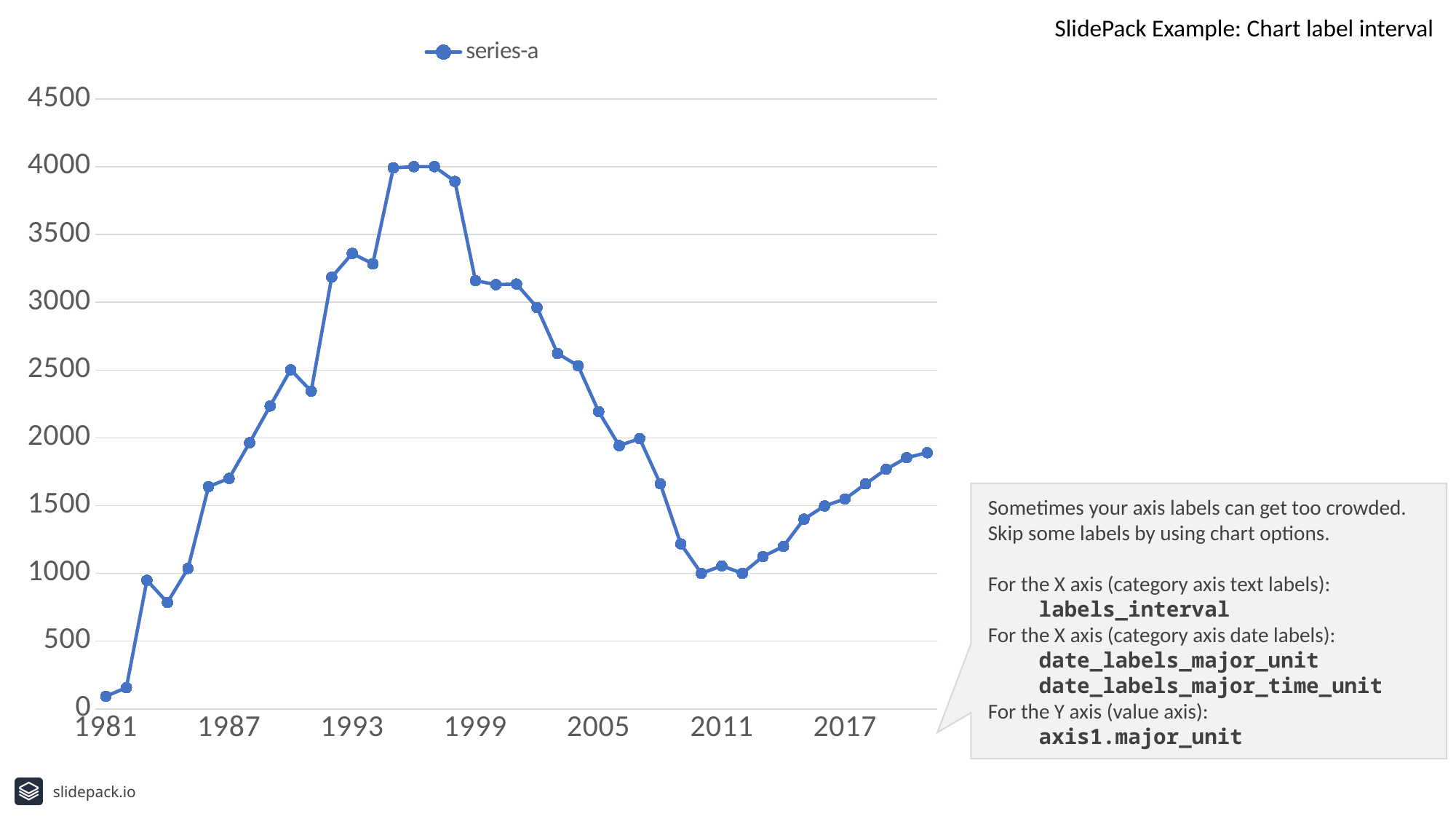
Do the values rise or fall between 1999 and 2011? fall What is the name of the series shown in the legend? series-a Is the value for 2005 greater or less than 2000? greater What is the first year label shown on the x axis? 1981 Which has the larger value, 1987 or 2005? 2005 How many series does the legend list? 1 Which labelled year on the x axis has the lowest value? 1981 Is the value for 2017 greater or less than 2000? less Is the value for 1987 greater or less than 1500? greater What kind of chart is shown on the slide? line chart